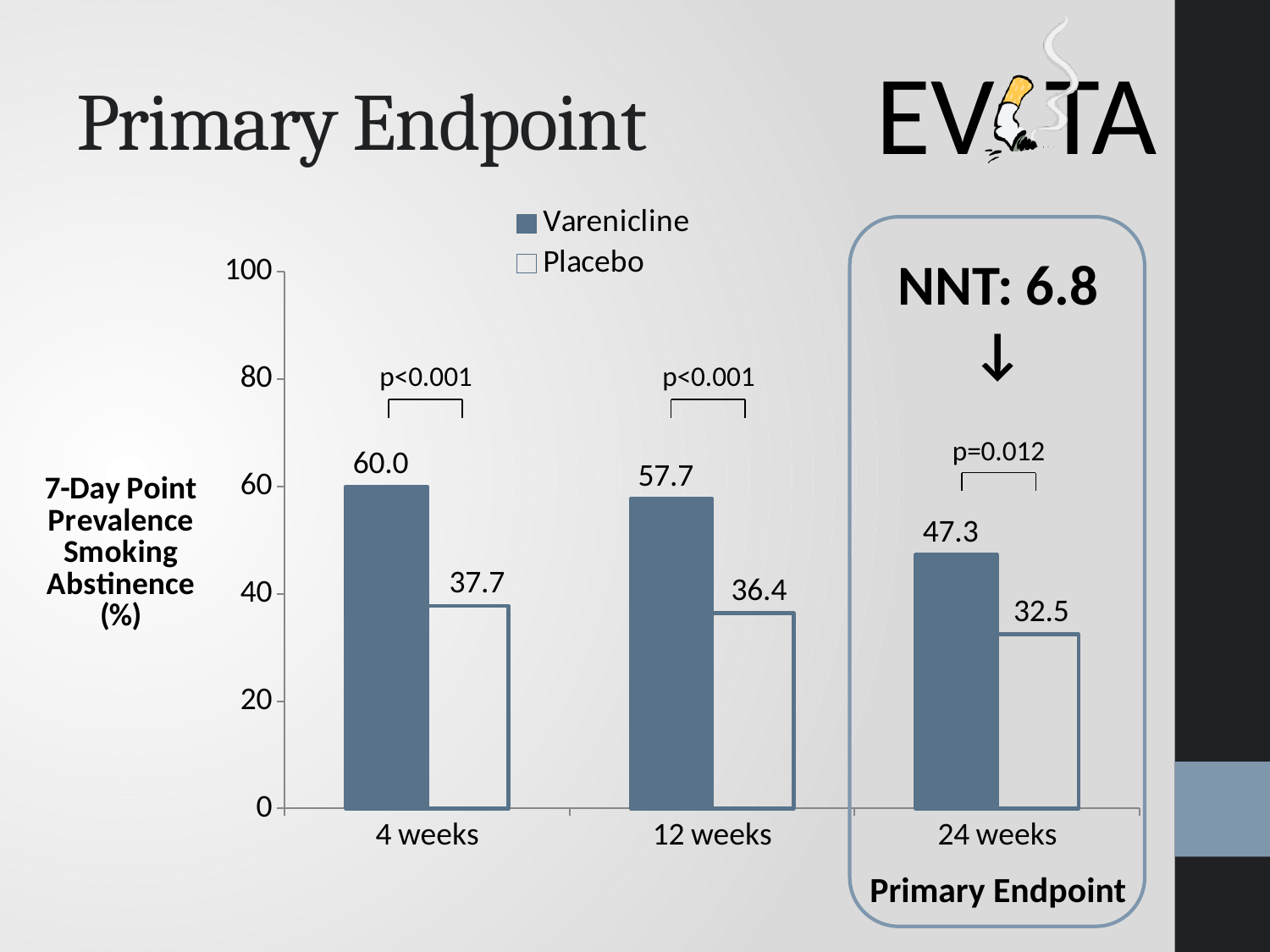
Do the Varenicline values rise or fall from 4 weeks to 24 weeks? Fall What is the Placebo value at 12 weeks? 36.4 At which time point is the Varenicline value lowest? 24 weeks What is the difference between the Varenicline and Placebo values at 24 weeks? 14.8 Which is larger at 12 weeks, Varenicline or Placebo? Varenicline At which time point is the Placebo value highest? 4 weeks What is the difference between the Varenicline values at 4 weeks and 12 weeks? 2.3 What is the Placebo value at 24 weeks? 32.5 What kind of chart is shown? Bar chart What is the Varenicline value at 4 weeks? 60.0 How many time points are shown on the x axis? 3 How many series does the legend list? 2